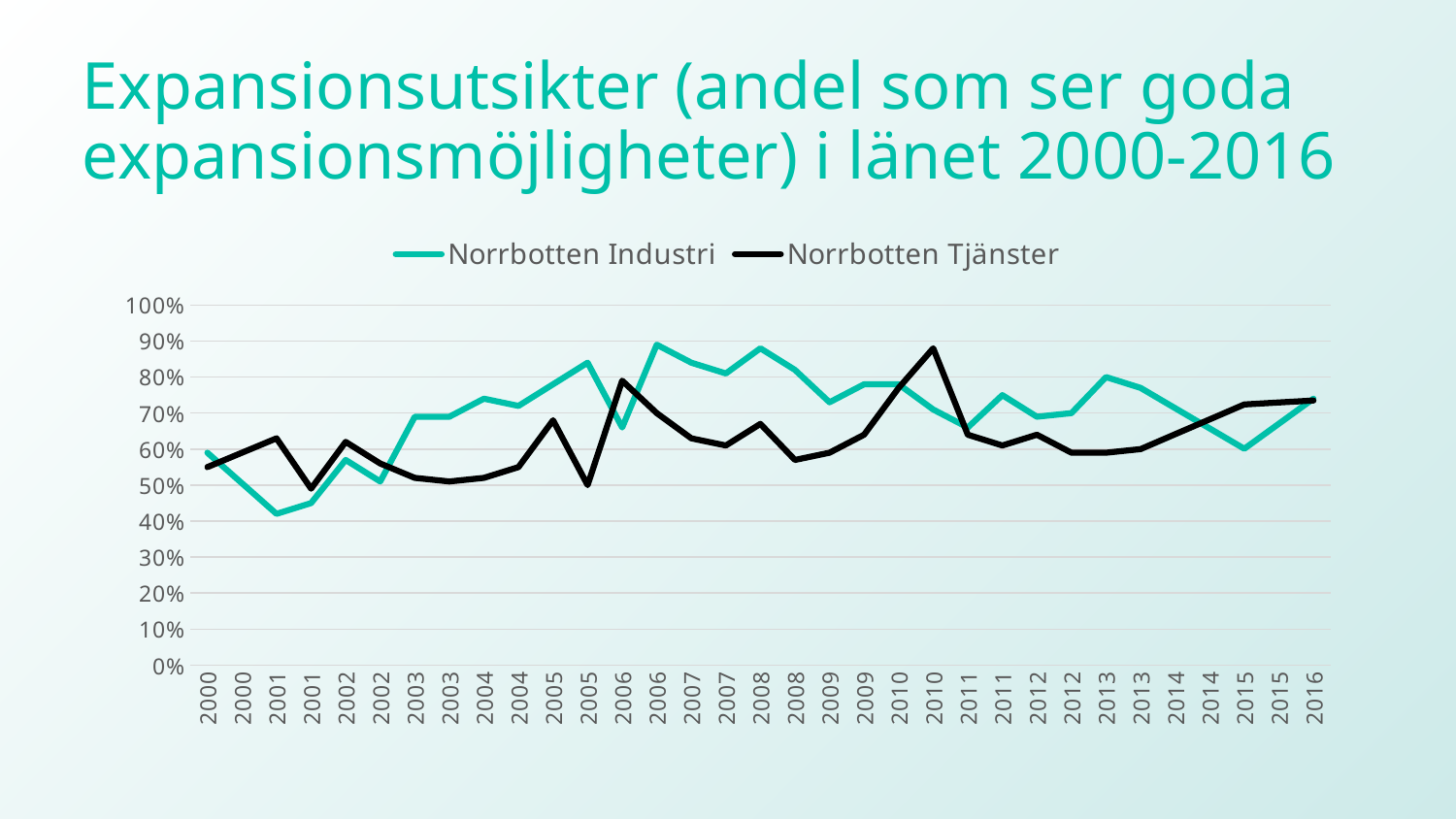
What are the two series named in the legend? Norrbotten Industri and Norrbotten Tjänster Is the value for Norrbotten Industri at the first 2008 point greater or less than 80%? greater Is the value for Norrbotten Tjänster at the first 2000 point greater or less than 60%? less In which year does the Norrbotten Industri line reach its lowest value? 2001 Is the value for Norrbotten Tjänster at the second 2010 point greater or less than 80%? greater Which colour is used for the Norrbotten Tjänster line? Black How many data points are plotted along the x axis for each series? 33 At the first 2001 point, which series has the higher value, Norrbotten Industri or Norrbotten Tjänster? Norrbotten Tjänster What kind of chart is shown on the slide? Line chart At the second 2010 point, which series has the higher value, Norrbotten Industri or Norrbotten Tjänster? Norrbotten Tjänster How many series does the legend list? 2